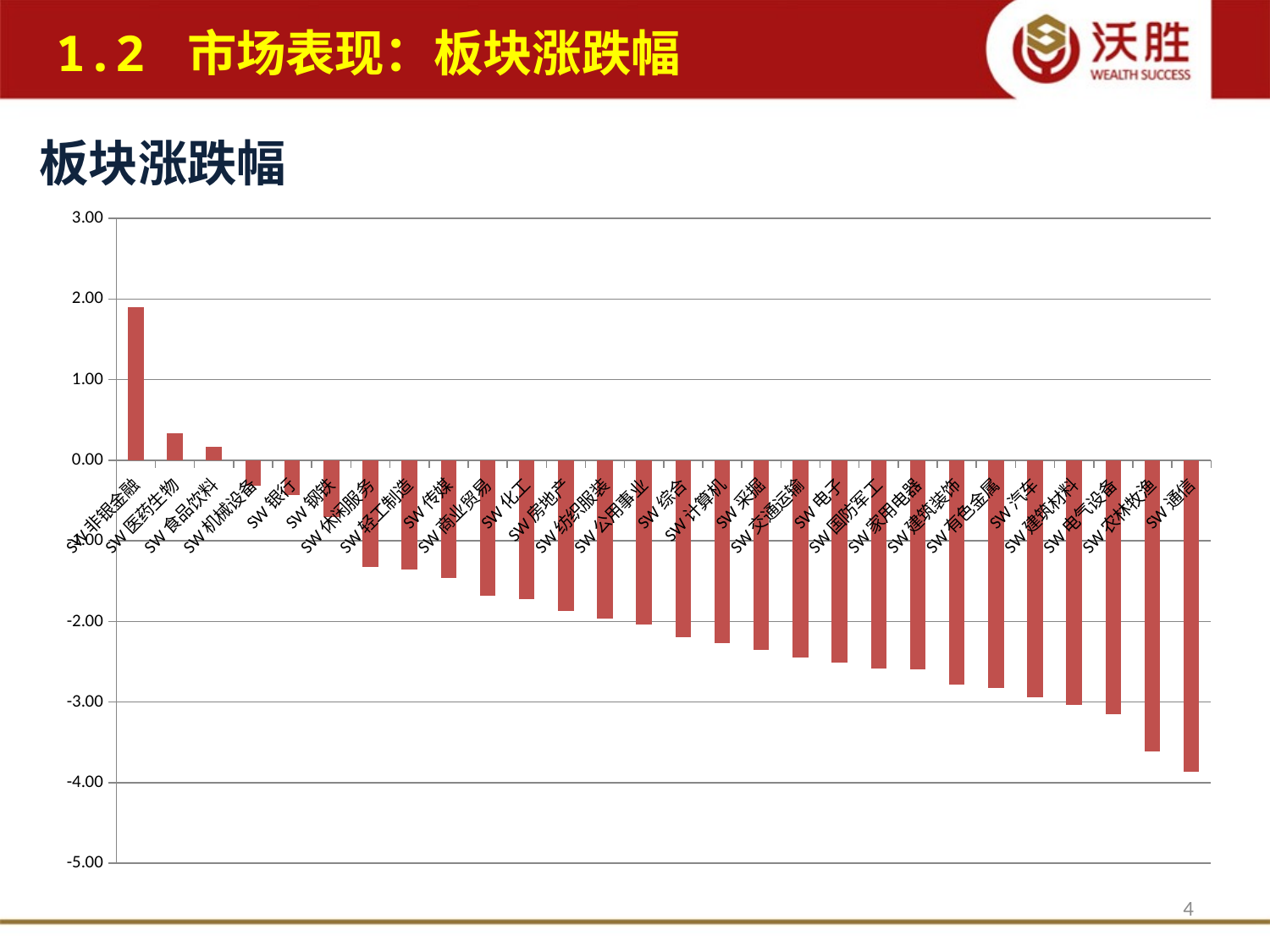
Which sector has the highest value in the chart? SW非银金融 Do the values rise or fall moving from left to right along the x axis? fall How many sectors have a positive value in the chart? 3 How many categories (sectors) are plotted in the chart? 28 Which is larger, the value for SW非银金融 or the value for SW医药生物? SW非银金融 What kind of chart is shown on the slide? bar chart Is the value for SW银行 greater or less than -1.00? greater Is the value for SW计算机 greater or less than -2.00? less Which sector has the lowest value in the chart? SW通信 Is the value for SW非银金融 greater or less than 1.00? greater What is the title of the chart? 板块涨跌幅